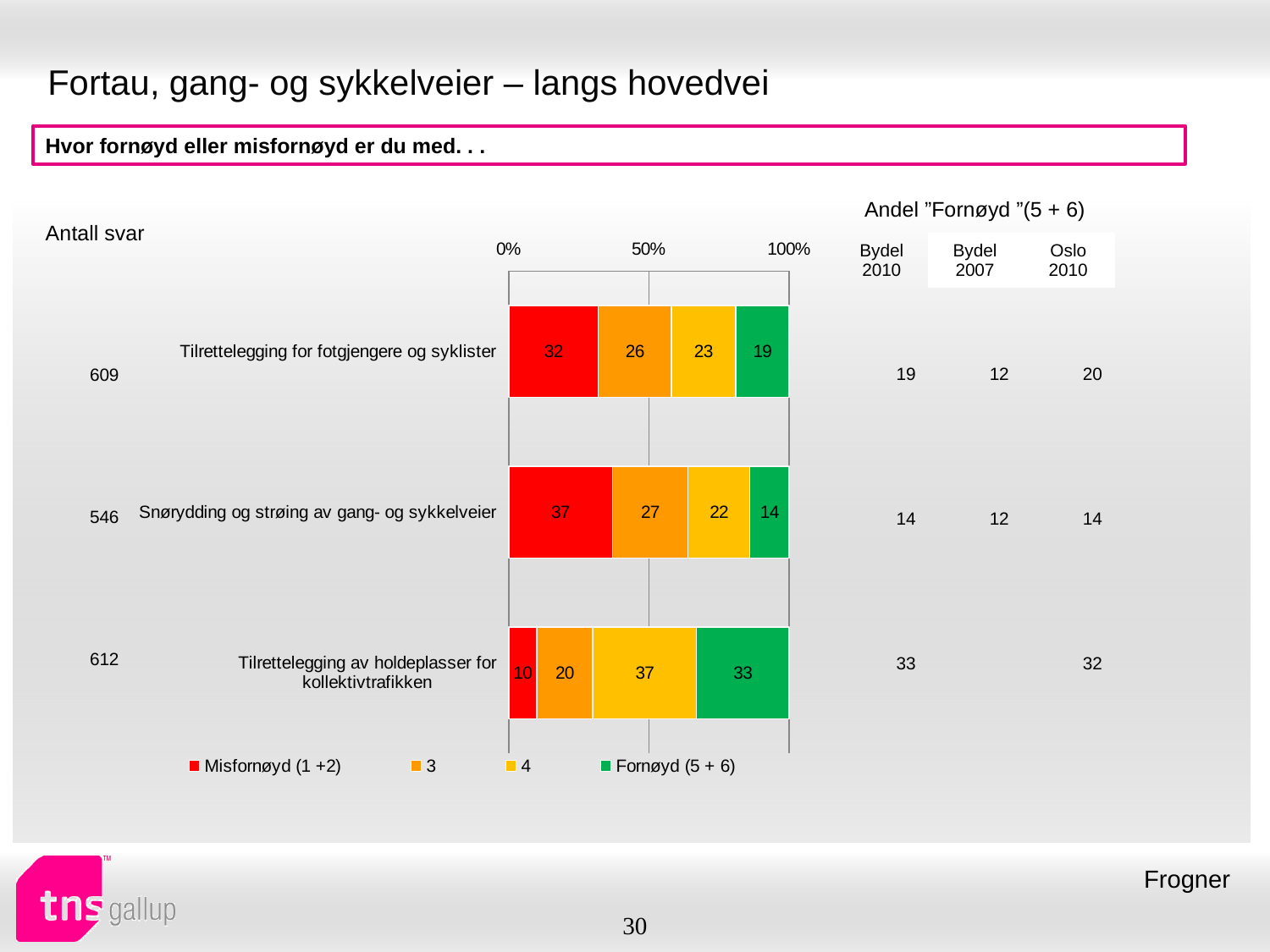
Which is larger: the '3' segment for 'Snørydding og strøing av gang- og sykkelveier' or the '3' segment for 'Tilrettelegging av holdeplasser for kollektivtrafikken'? Snørydding og strøing av gang- og sykkelveier How many series does the chart legend list? 4 What is the value of the 'Fornøyd (5 + 6)' segment for 'Tilrettelegging av holdeplasser for kollektivtrafikken'? 33 What is the value of the '4' segment for 'Tilrettelegging for fotgjengere og syklister'? 23 What is the total of the stacked bar for 'Tilrettelegging for fotgjengere og syklister'? 100 Which category has the lowest 'Misfornøyd (1 +2)' value? Tilrettelegging av holdeplasser for kollektivtrafikken Which colour represents the 'Fornøyd (5 + 6)' series in the chart? Green What is the value of the 'Misfornøyd (1 +2)' segment for 'Snørydding og strøing av gang- og sykkelveier'? 37 Which category has the highest 'Fornøyd (5 + 6)' value? Tilrettelegging av holdeplasser for kollektivtrafikken What type of chart is shown on the slide? Stacked bar chart What is the difference between the 'Misfornøyd (1 +2)' values for 'Snørydding og strøing av gang- og sykkelveier' and 'Tilrettelegging for fotgjengere og syklister'? 5 How many categories are plotted in the chart? 3